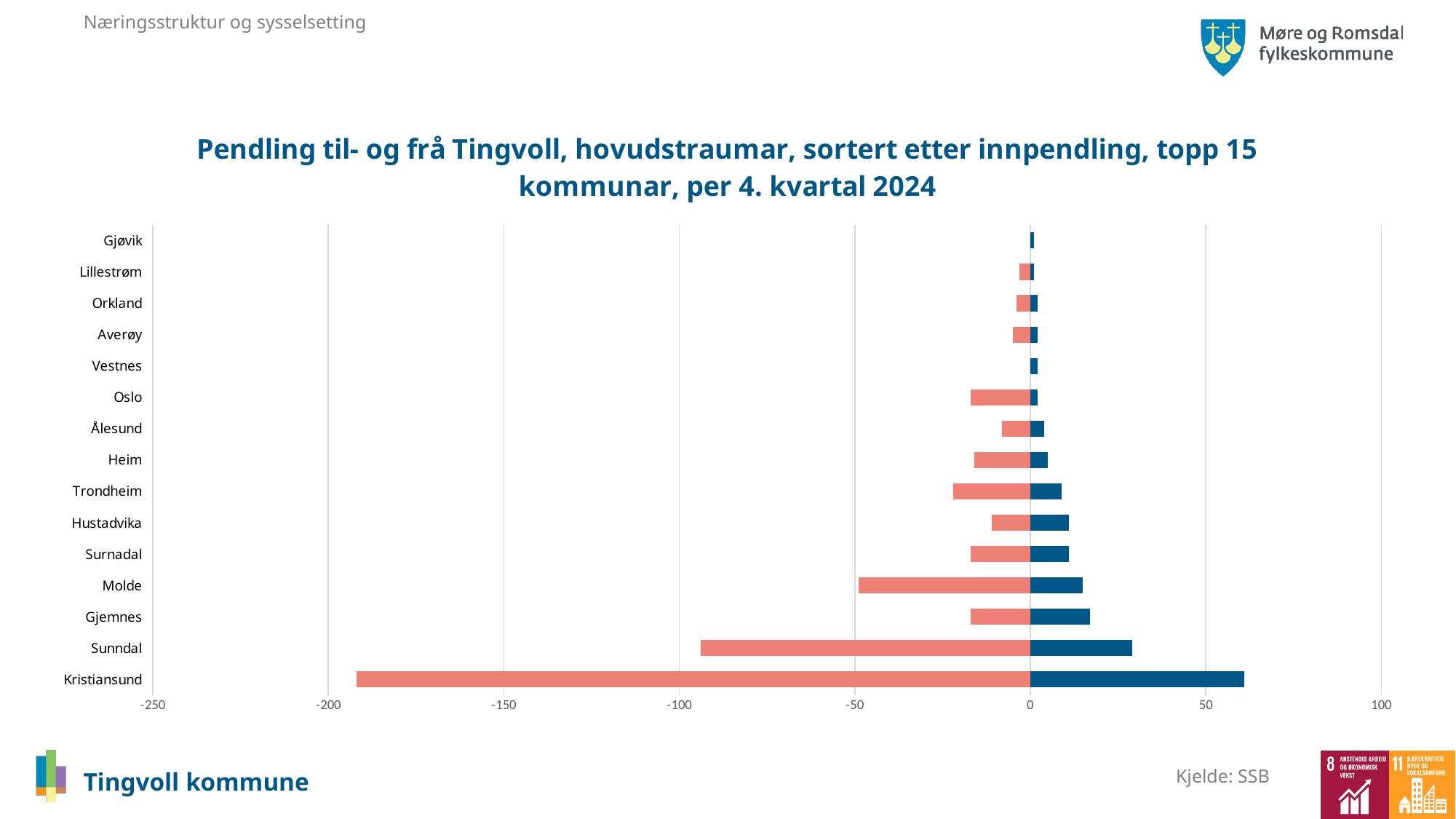
Which municipality has the longest blue bar (highest innpendling)? Kristiansund Is the blue bar value for Kristiansund greater or less than 50? greater Which municipality has the longest red bar extending furthest to the left? Kristiansund Which has the longer red bar, Sunndal or Molde? Sunndal Is the red bar value for Kristiansund greater or less than -150? less What kind of chart is shown on the slide? bar chart Is the red bar value for Sunndal greater or less than -50? less How many municipalities are listed on the vertical axis of the chart? 15 Do the blue bars get longer or shorter moving from the top of the chart (Gjøvik) to the bottom (Kristiansund)? longer Which has the longer blue bar, Sunndal or Gjemnes? Sunndal What source is cited for the chart data? SSB